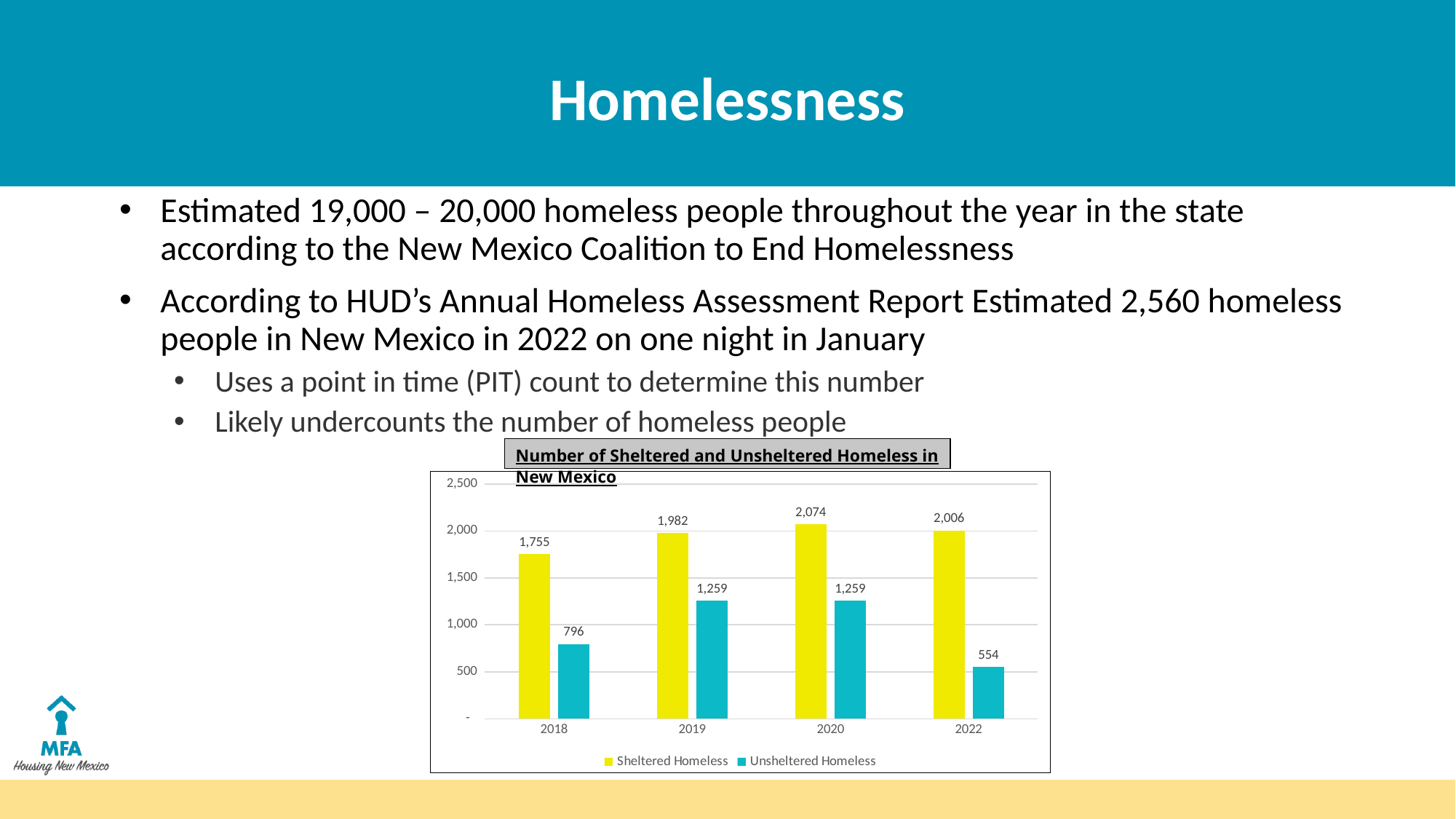
What kind of chart is shown on the slide? Bar chart What is the title of the chart? Number of Sheltered and Unsheltered Homeless in New Mexico Is the value for Sheltered Homeless in 2019 greater or less than 1,500? greater What is the value for Unsheltered Homeless in 2022? 554 Which year has the lowest Unsheltered Homeless value? 2022 Which year has the highest Sheltered Homeless value? 2020 What is the difference between Sheltered Homeless and Unsheltered Homeless in 2020? 815 How many series does the legend list? 2 How many years are shown on the x axis? 4 What is the value for Sheltered Homeless in 2018? 1,755 Which is larger: Unsheltered Homeless in 2018 or Unsheltered Homeless in 2022? Unsheltered Homeless in 2018 What is the value for Unsheltered Homeless in 2019? 1,259